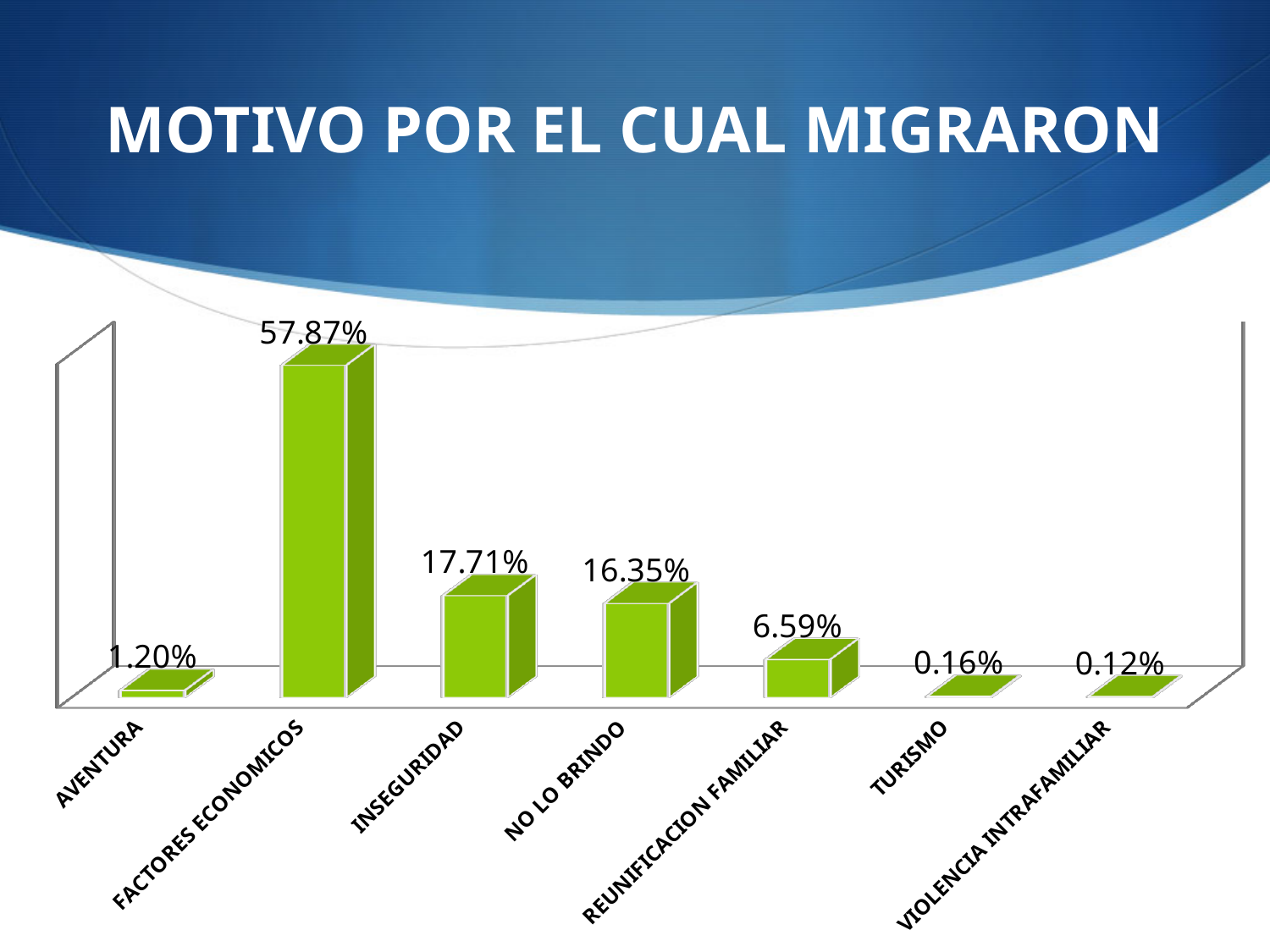
What is the difference between the values for INSEGURIDAD and NO LO BRINDO? 1.36% What is the difference between the values for FACTORES ECONOMICOS and INSEGURIDAD? 40.16% Which is larger, the value for AVENTURA or the value for REUNIFICACION FAMILIAR? REUNIFICACION FAMILIAR What kind of chart is shown on the slide? Bar chart What is the value for FACTORES ECONOMICOS? 57.87% What is the value for TURISMO? 0.16% What is the title of the slide? MOTIVO POR EL CUAL MIGRARON Which category has the lowest value? VIOLENCIA INTRAFAMILIAR Which category has the highest value? FACTORES ECONOMICOS What is the value for INSEGURIDAD? 17.71% How many categories are shown in the chart? 7 What is the value for REUNIFICACION FAMILIAR? 6.59%